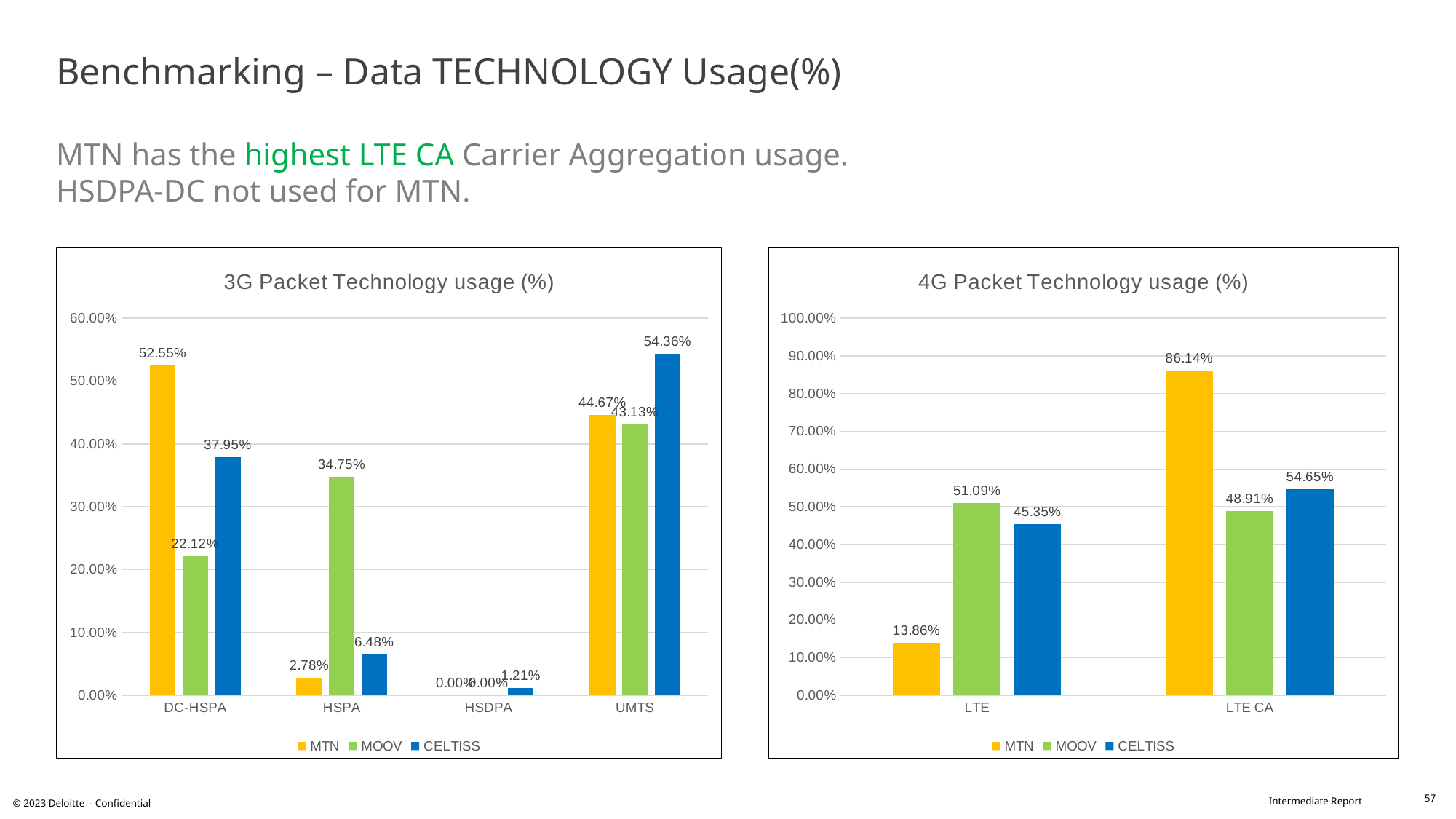
In the 3G Packet Technology usage (%) chart, what is the value for MOOV in HSPA? 34.75% In the 3G Packet Technology usage (%) chart, which series has the highest value for UMTS? CELTISS In the 4G Packet Technology usage (%) chart, is the value for MOOV in LTE greater or less than 50.00%? greater In the 4G Packet Technology usage (%) chart, what is the value for MTN in LTE CA? 86.14% In the 4G Packet Technology usage (%) chart, what is the difference between CELTISS and MOOV for LTE CA? 5.74% In the 3G Packet Technology usage (%) chart, what is the difference between MTN and CELTISS for DC-HSPA? 14.60% In the 3G Packet Technology usage (%) chart, what is the value for MTN in DC-HSPA? 52.55% In the 4G Packet Technology usage (%) chart, which series has the lowest value for LTE? MTN In the 3G Packet Technology usage (%) chart, how many technology categories are shown on the x axis? 4 What type of chart is the 3G Packet Technology usage (%) chart? Bar chart In the 3G Packet Technology usage (%) chart, what is the value for CELTISS in HSDPA? 1.21% How many series does the legend of the 4G Packet Technology usage (%) chart list? 3